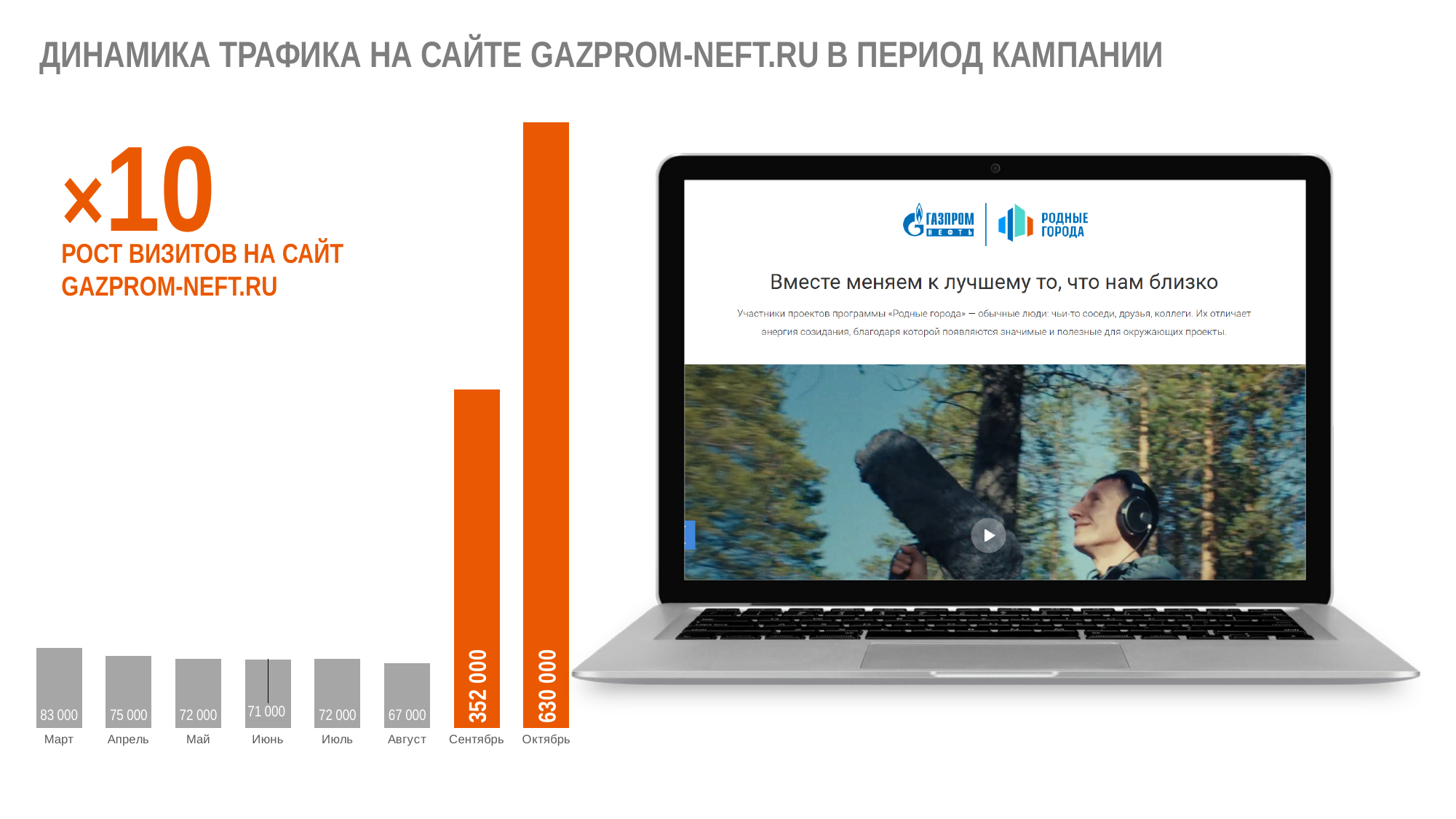
What is the value for Март? 83 000 What is the value for Октябрь? 630 000 What is the value for Август? 67 000 Which month has the lowest value? Август Which is larger, the value for Апрель or the value for Июнь? Апрель What is the difference between the values for Март and Апрель? 8 000 What is the difference between the values for Октябрь and Сентябрь? 278 000 What kind of chart is shown on the slide? Bar chart How many months are shown in the chart? 8 What is the value for Сентябрь? 352 000 What colour are the bars for Сентябрь and Октябрь? Orange Which month has the highest value? Октябрь